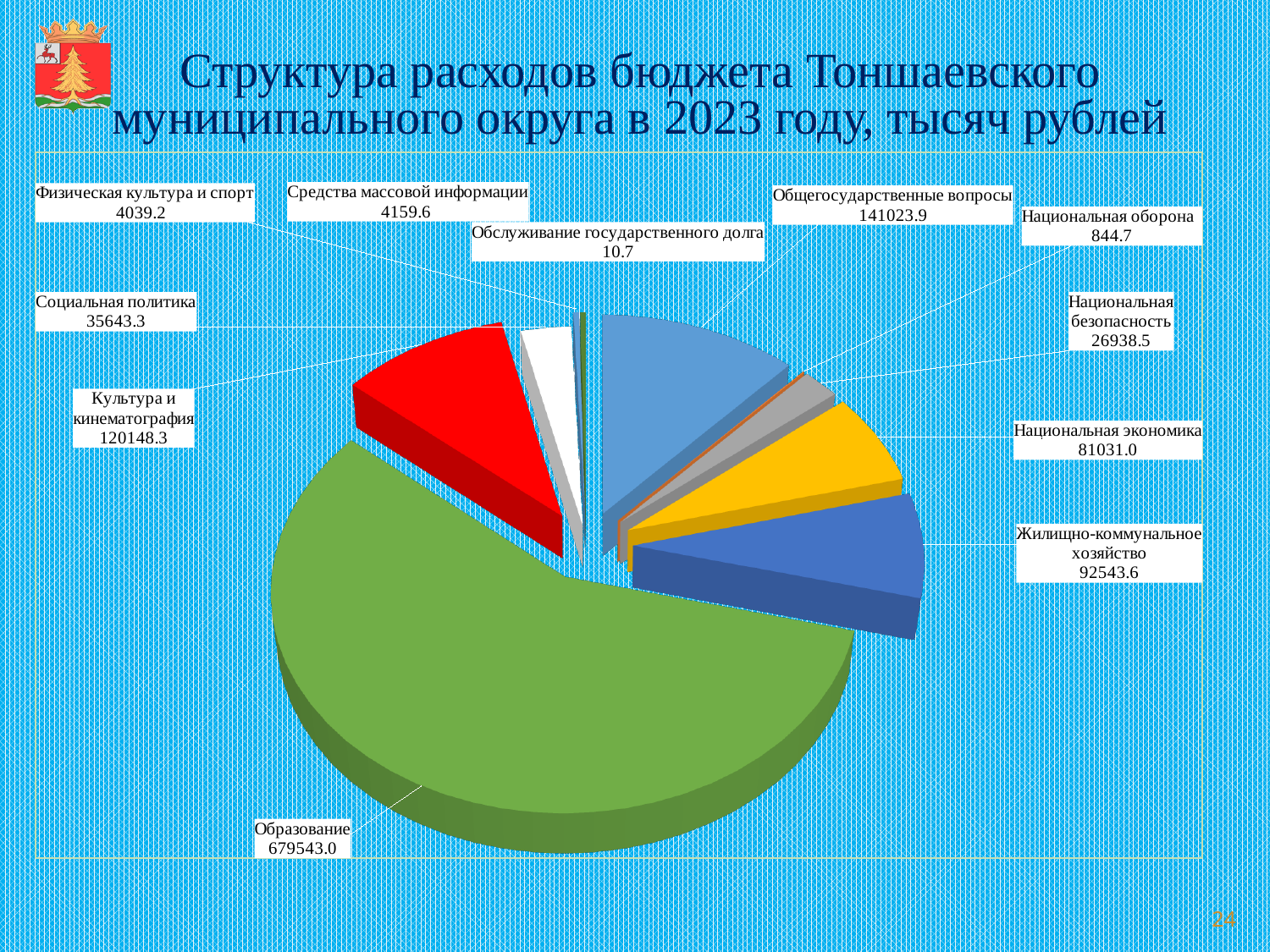
Which category has the largest value? Образование What kind of chart is shown on the slide? pie chart What is the difference between Общегосударственные вопросы and Культура и кинематография? 20875.6 How many categories are shown in the pie chart? 11 What is the value for Образование? 679543.0 Which category has the smallest value? Обслуживание государственного долга What is the value for Обслуживание государственного долга? 10.7 What is the value for Национальная безопасность? 26938.5 What is the value for Общегосударственные вопросы? 141023.9 Which is larger, Культура и кинематография or Жилищно-коммунальное хозяйство? Культура и кинематография What is the title of the chart? Структура расходов бюджета Тоншаевского муниципального округа в 2023 году, тысяч рублей What is the difference between Жилищно-коммунальное хозяйство and Национальная экономика? 11512.6